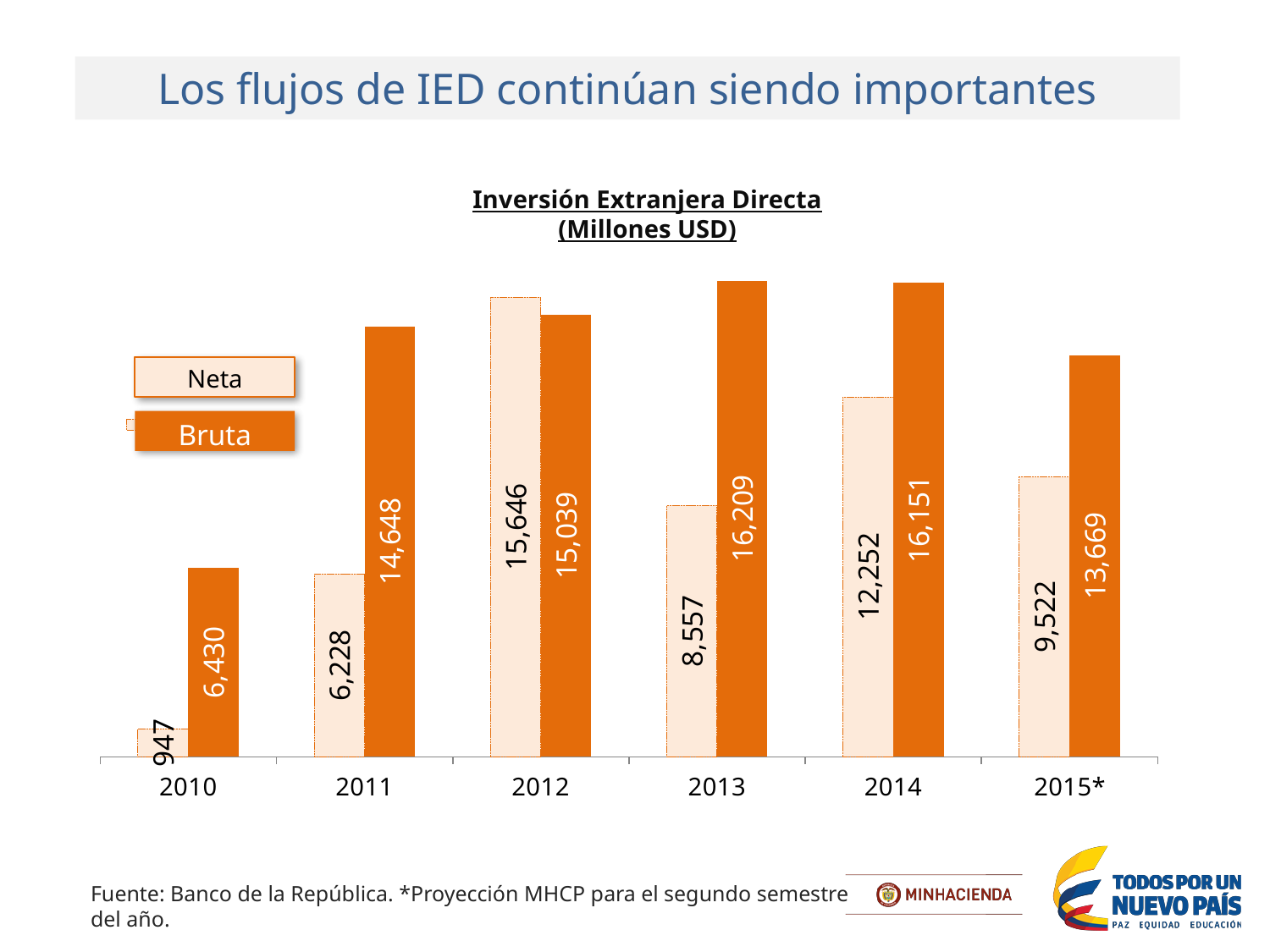
What is the Neta value for 2010 in the Inversión Extranjera Directa chart? 947 What is the difference between the Bruta and Neta values in 2013? 7,652 In 2012, which is larger, the Neta value or the Bruta value? Neta What is the difference between the Neta and Bruta values in 2012? 607 How many series does the legend list? 2 Which year has the lowest Neta value? 2010 Which year has the highest Neta value? 2012 What kind of chart is shown on the slide? Bar chart What is the Bruta value for 2013? 16,209 How many years are shown on the x axis of the chart? 6 What is the Neta value for 2015*? 9,522 Which year has the highest Bruta value? 2013